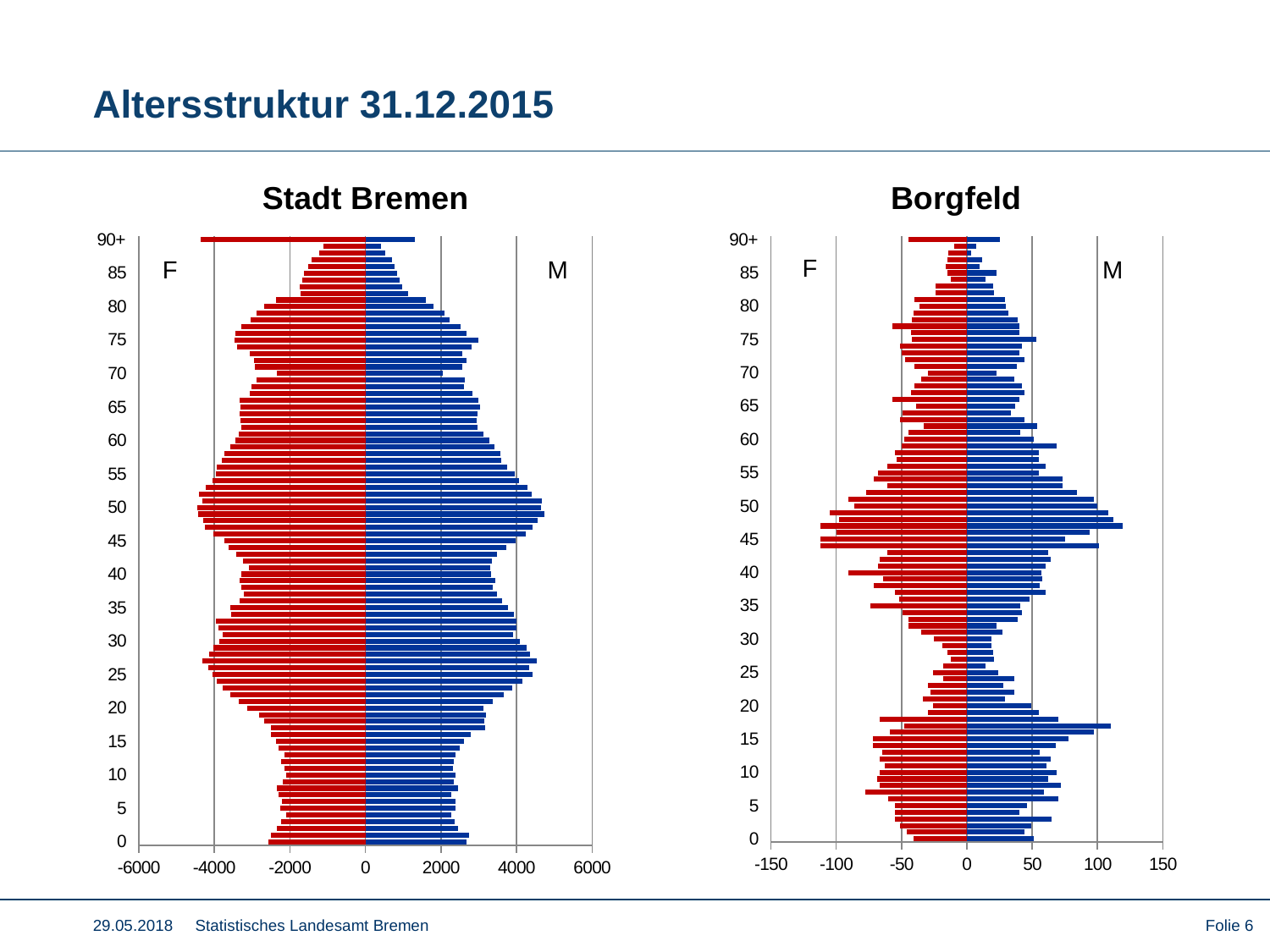
In the Stadt Bremen chart, which is larger: the male (M) value at age 50 or the male (M) value at age 10? age 50 In the Stadt Bremen chart, is the male (M) value at age 90+ greater or less than 2000? less In the Borgfeld chart, is the male (M) value at age 30 greater or less than 50? less What kind of chart is the Stadt Bremen chart? bar chart In the Stadt Bremen chart, is the male (M) value at age 50 greater or less than 4000? greater In the Stadt Bremen chart, which colour represents the female (F) population? red In the Borgfeld chart, which colour represents the male (M) population? blue